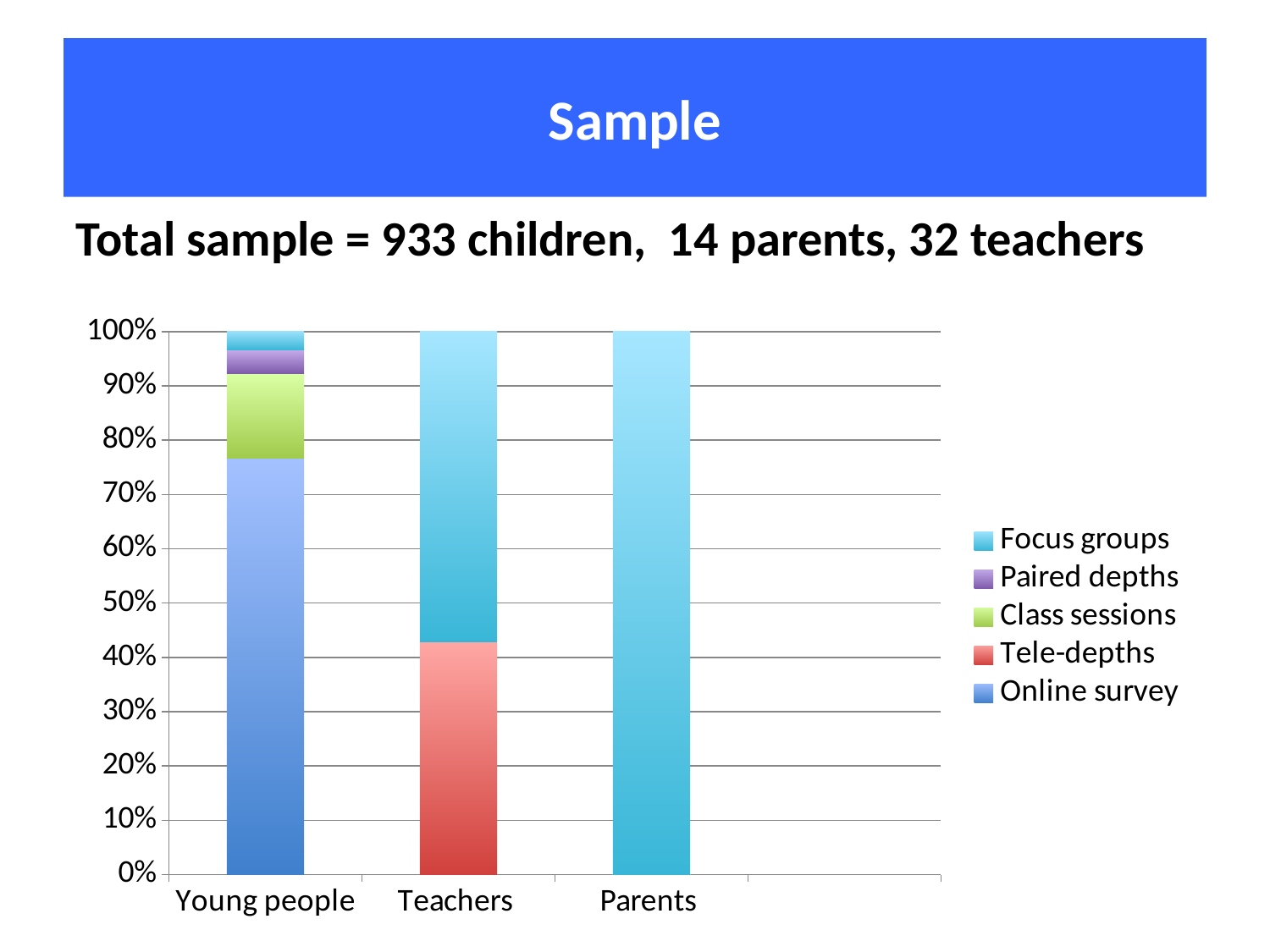
What is the total height of the Young people stacked bar? 100% Is the Tele-depths value for Teachers greater or less than 50%? less How many categories are shown on the x axis of the chart? 3 How many series does the chart's legend list? 5 Which category has the largest Focus groups share? Parents Is the Online survey value for Young people greater or less than 70%? greater Is the Class sessions value for Young people greater or less than 20%? less Which series is listed first in the chart's legend? Focus groups What kind of chart is shown on the slide? stacked bar chart What share of the Parents bar is made up of Focus groups? 100% For Young people, which is larger: the Online survey segment or the Class sessions segment? Online survey For Teachers, which is larger: the Focus groups segment or the Tele-depths segment? Focus groups